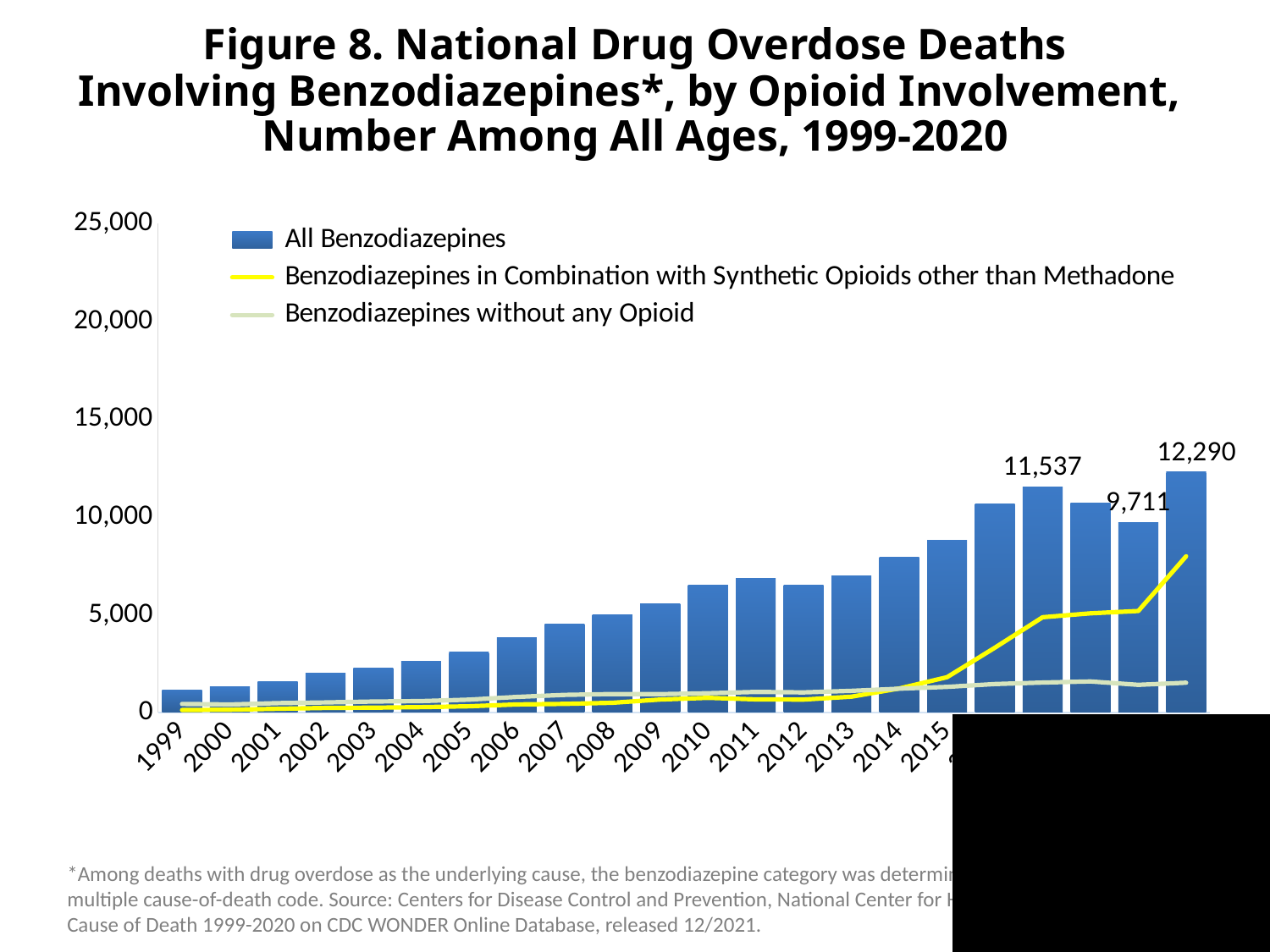
How many series does the legend list? 3 Which line series reaches the higher value at the right end of the chart? Benzodiazepines in Combination with Synthetic Opioids other than Methadone Which series is drawn as bars? All Benzodiazepines Do the All Benzodiazepines values generally rise or fall from 1999 to 2010? rise What is the difference between the labelled values 11,537 and 9,711 for All Benzodiazepines? 1,826 What is the highest labelled value for All Benzodiazepines? 12,290 Which year has the larger All Benzodiazepines value, 2005 or 2010? 2010 What kind of chart is shown on the slide? A bar chart with line overlays Is the All Benzodiazepines value for 1999 greater or less than 5,000? less What is the maximum value shown on the vertical axis? 25,000 Is the All Benzodiazepines value for 2014 greater or less than 5,000? greater What is the difference between the labelled values 12,290 and 11,537 for All Benzodiazepines? 753